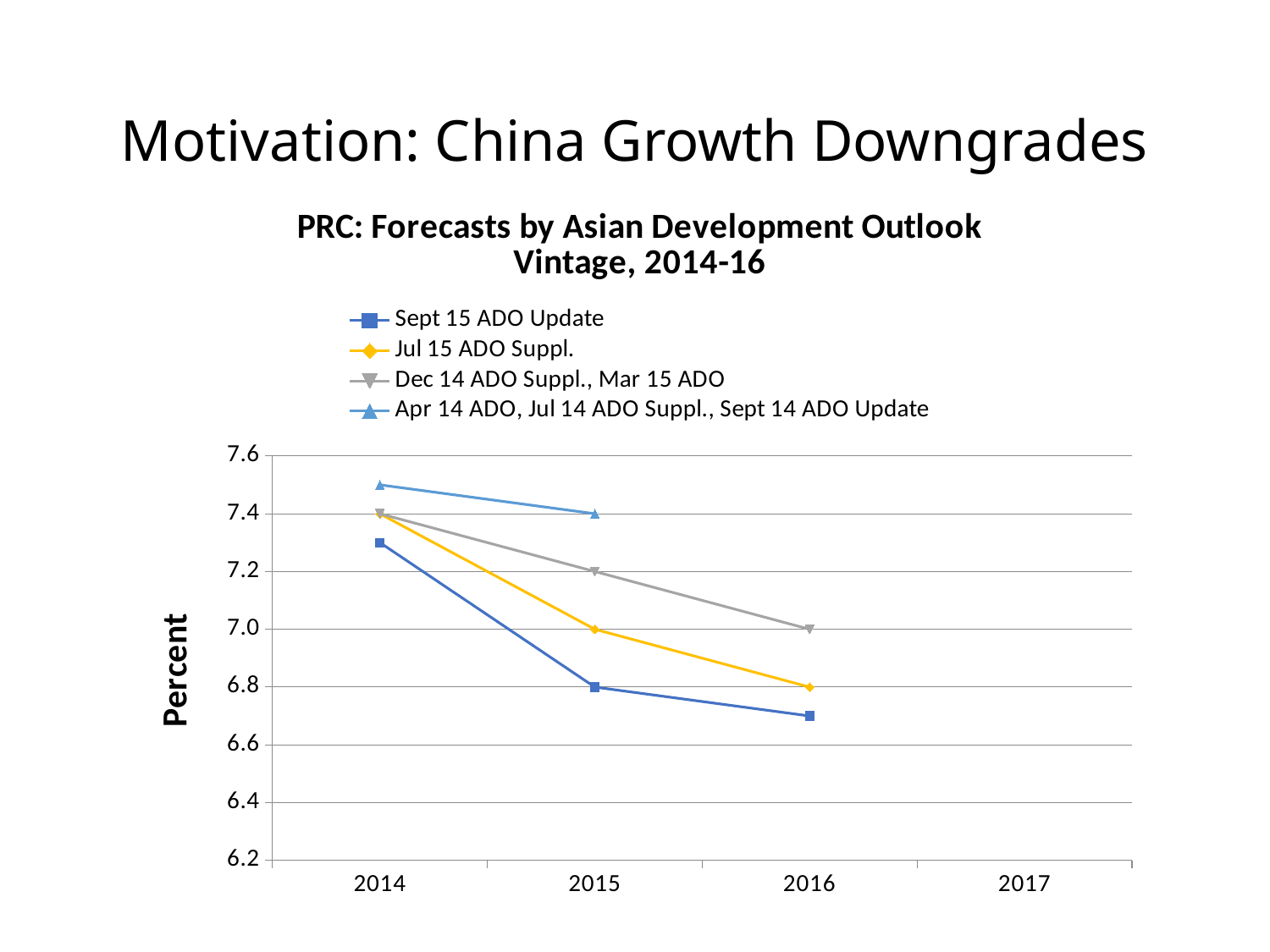
What is the value of the Dec 14 ADO Suppl., Mar 15 ADO series for 2016? 7.0 What is the value of the Sept 15 ADO Update series for 2015? 6.8 How many series does the legend list? 4 Do the values of the Jul 15 ADO Suppl. series rise or fall from 2014 to 2016? fall What is the difference between the Dec 14 ADO Suppl., Mar 15 ADO value and the Jul 15 ADO Suppl. value for 2015? 0.2 What is the value of the Apr 14 ADO, Jul 14 ADO Suppl., Sept 14 ADO Update series for 2015? 7.4 What is the value of the Jul 15 ADO Suppl. series for 2015? 7.0 Is the value of the Apr 14 ADO, Jul 14 ADO Suppl., Sept 14 ADO Update series for 2014 greater or less than 7.4? greater Which series has the lowest value for 2016? Sept 15 ADO Update What is the label on the vertical axis of the chart? Percent Is the value of the Sept 15 ADO Update series for 2016 greater or less than 6.8? less What kind of chart is shown on the slide? line chart